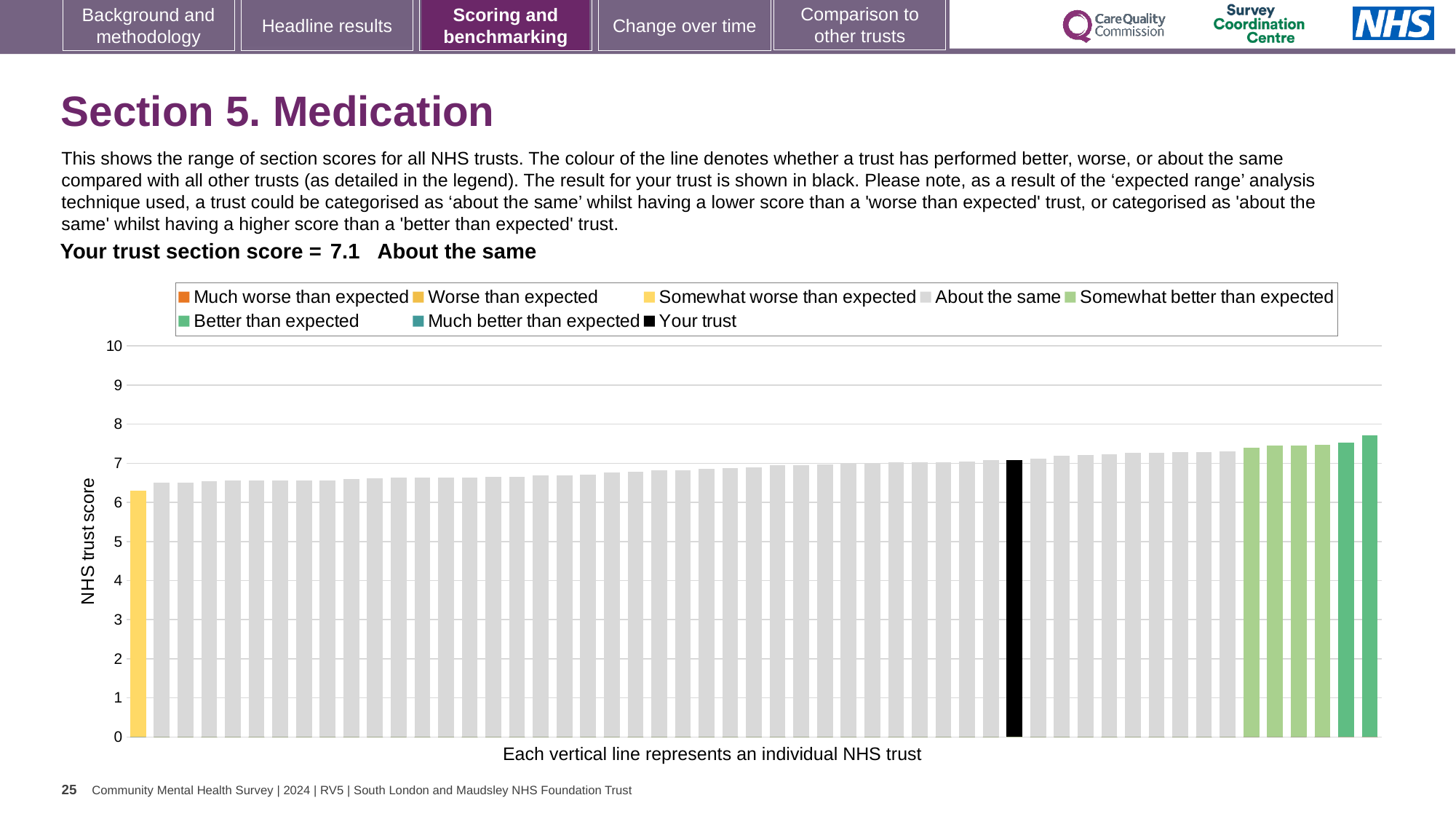
What is the section score for your trust shown on the slide? 7.1 Do the trust scores rise or fall from left to right along the x axis? rise Which performance category is your trust placed in according to the slide? About the same Is the score for your trust (black bar) higher or lower than the score for the leftmost yellow bar? higher Is the value for the highest-scoring trust greater or less than 8? less What is the highest value shown on the y axis? 10 What is the label of the y axis? NHS trust score How many entries does the chart legend list? 8 Is the value for the lowest-scoring trust greater or less than 7? less What kind of chart is shown on the slide? bar chart Is the value for the highest-scoring trust greater or less than 7? greater